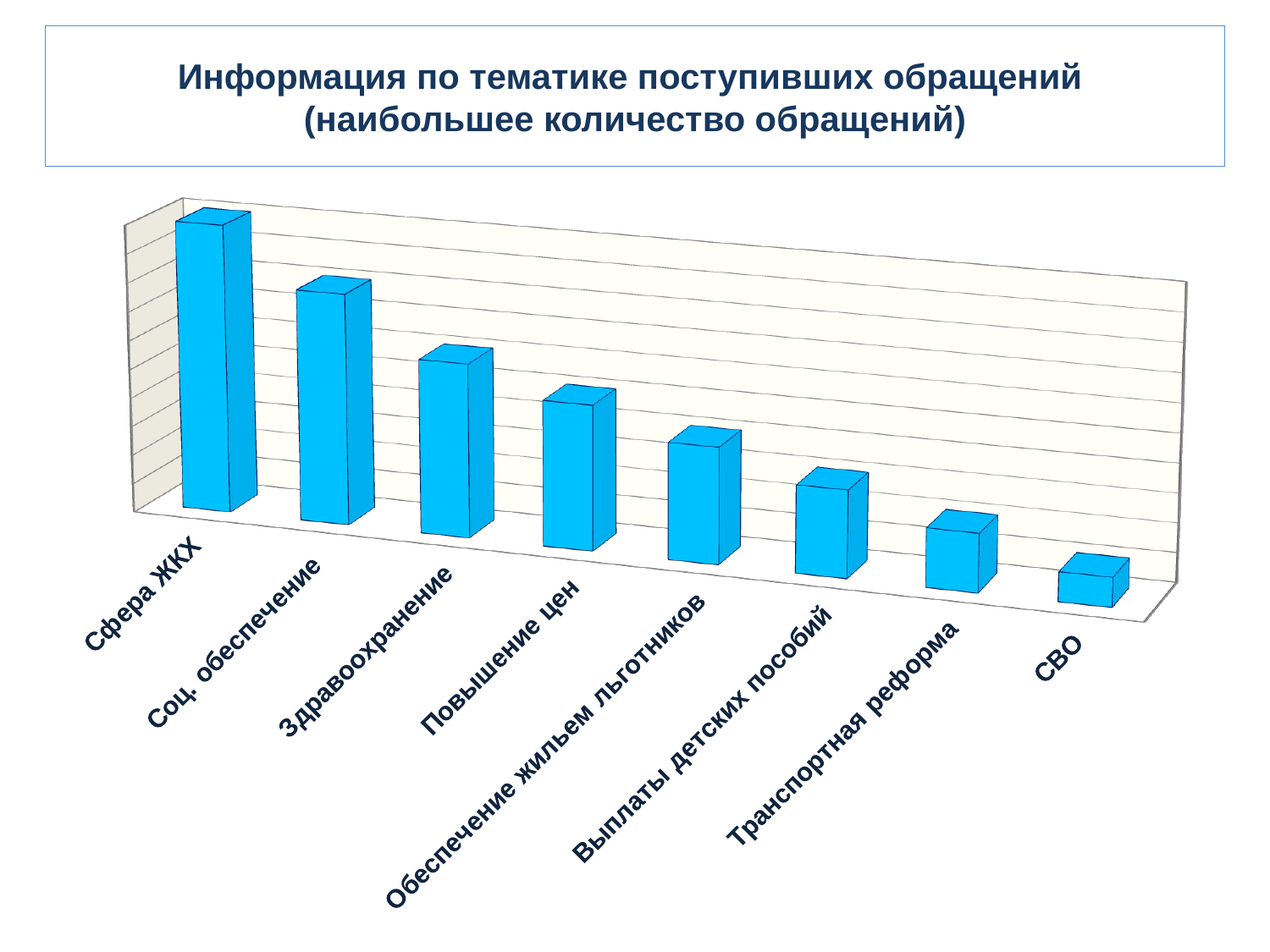
Which is larger, the value for Транспортная реформа or the value for Выплаты детских пособий? Выплаты детских пособий Which category has the highest bar? Сфера ЖКХ How many categories are shown in the chart? 8 What colour are the bars in the chart? Blue Which is larger, the value for Соц. обеспечение or the value for Обеспечение жильем льготников? Соц. обеспечение Which category has the lowest bar? СВО Which category has the second-highest bar? Соц. обеспечение What kind of chart is shown on the slide? Bar chart Which category has the second-lowest bar? Транспортная реформа Do the bar values rise or fall from left to right along the x axis? Fall What is the title of the slide? Информация по тематике поступивших обращений (наибольшее количество обращений) Which is larger, the value for Здравоохранение or the value for Повышение цен? Здравоохранение